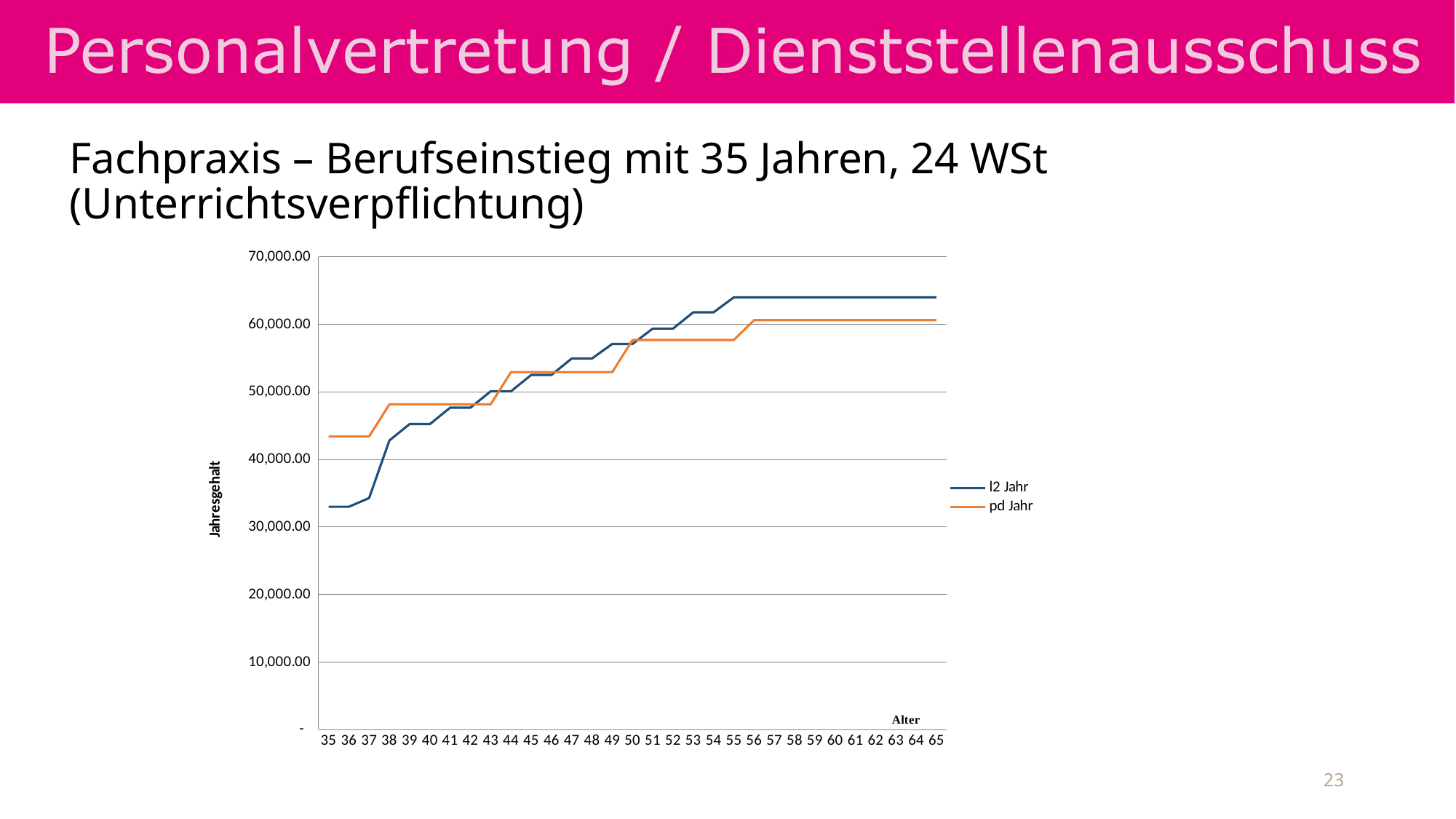
What kind of chart is shown on the slide? line chart Is the value for pd Jahr at age 35 greater or less than 40,000.00? greater Is the value for pd Jahr at age 65 greater or less than 50,000.00? greater How many age values are shown along the x axis? 31 How many series does the legend list? 2 At age 35, which series has the higher value, l2 Jahr or pd Jahr? pd Jahr At age 65, which series has the higher value, l2 Jahr or pd Jahr? l2 Jahr Do the values of the l2 Jahr series rise or fall as age increases along the x axis? rise Is the value for l2 Jahr at age 35 greater or less than 40,000.00? less What is the label of the vertical axis? Jahresgehalt Which series reaches the highest value on the chart? l2 Jahr